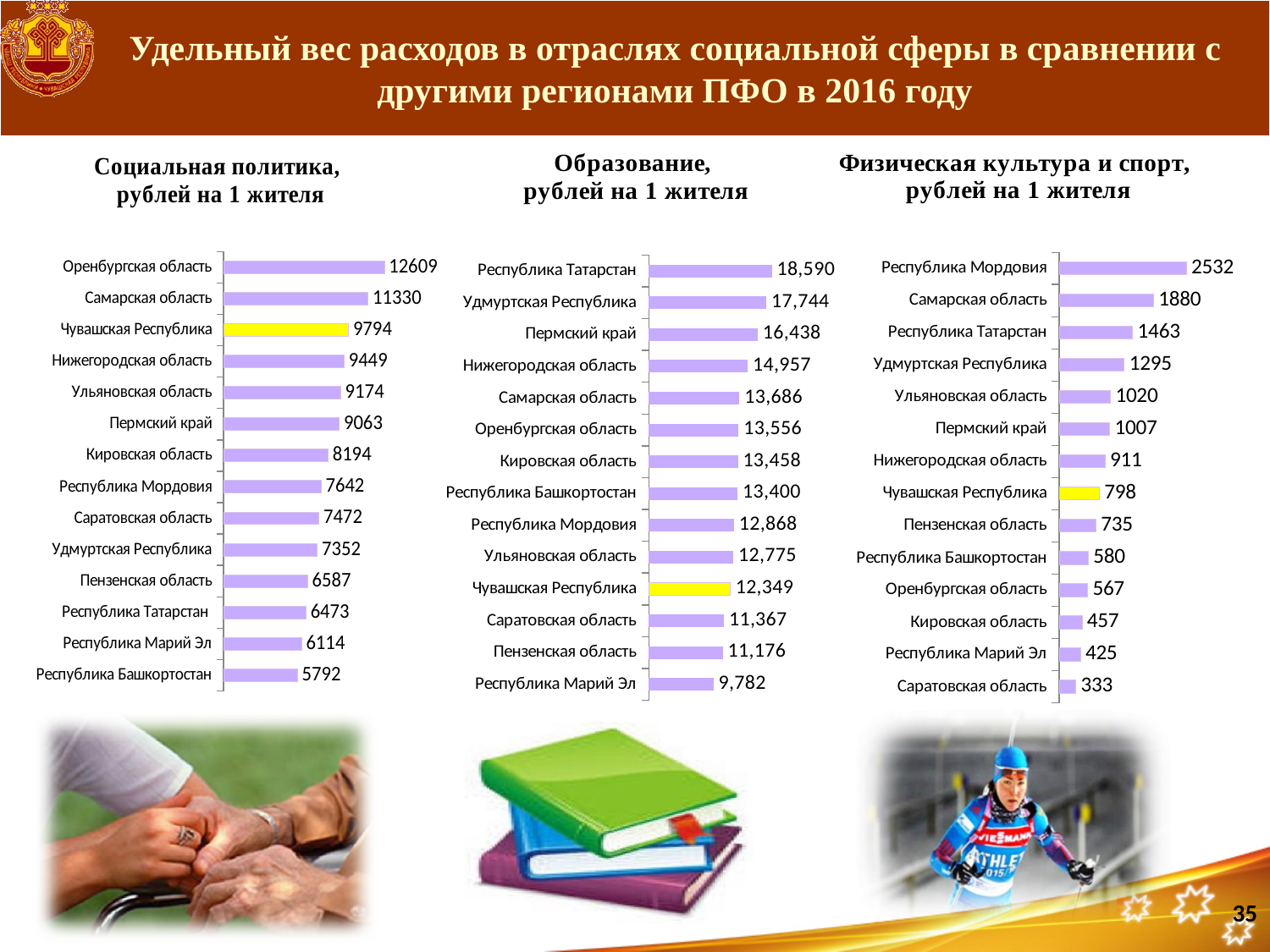
What type of chart is used for 'Социальная политика, рублей на 1 жителя'? Bar chart On the 'Социальная политика, рублей на 1 жителя' chart, what is the difference between Оренбургская область and Чувашская Республика? 2815 On the 'Социальная политика, рублей на 1 жителя' chart, which region has the highest value? Оренбургская область On the 'Образование, рублей на 1 жителя' chart, how many regions are shown? 14 On the 'Физическая культура и спорт, рублей на 1 жителя' chart, which is larger: Самарская область or Республика Татарстан? Самарская область On the 'Социальная политика, рублей на 1 жителя' chart, what is the value for Чувашская Республика? 9794 On the 'Социальная политика, рублей на 1 жителя' chart, which region has the lowest value? Республика Башкортостан On the 'Физическая культура и спорт, рублей на 1 жителя' chart, which region has the lowest value? Саратовская область On the 'Образование, рублей на 1 жителя' chart, what is the value for Пермский край? 16,438 On the 'Физическая культура и спорт, рублей на 1 жителя' chart, what is the value for Ульяновская область? 1020 On the 'Образование, рублей на 1 жителя' chart, what is the difference between Республика Татарстан and Республика Марий Эл? 8,808 On the 'Образование, рублей на 1 жителя' chart, which region has the highest value? Республика Татарстан